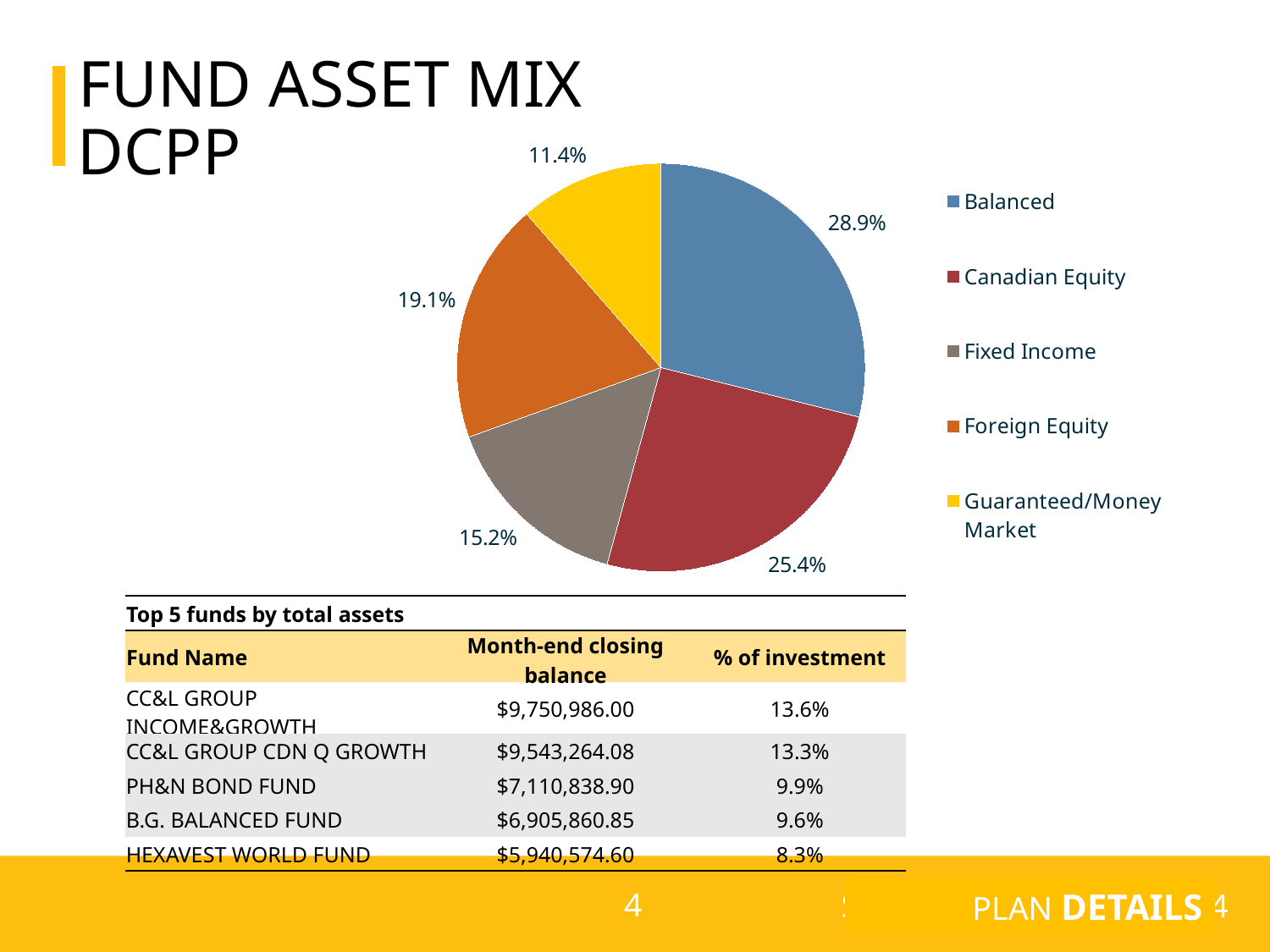
What percentage of the fund asset mix is Balanced? 28.9% What percentage of the fund asset mix is Foreign Equity? 19.1% What colour is the Guaranteed/Money Market slice in the pie chart? yellow What share of the pie does Guaranteed/Money Market represent? 11.4% Which is larger, the share for Foreign Equity or the share for Fixed Income? Foreign Equity Which asset class has the largest share of the fund asset mix? Balanced Which asset class has the smallest share of the fund asset mix? Guaranteed/Money Market What percentage of the fund asset mix is Fixed Income? 15.2% What percentage of the fund asset mix is Canadian Equity? 25.4% What type of chart is shown on the slide? pie chart How many slices does the pie chart have? 5 What is the difference in percentage points between Balanced and Canadian Equity? 3.5